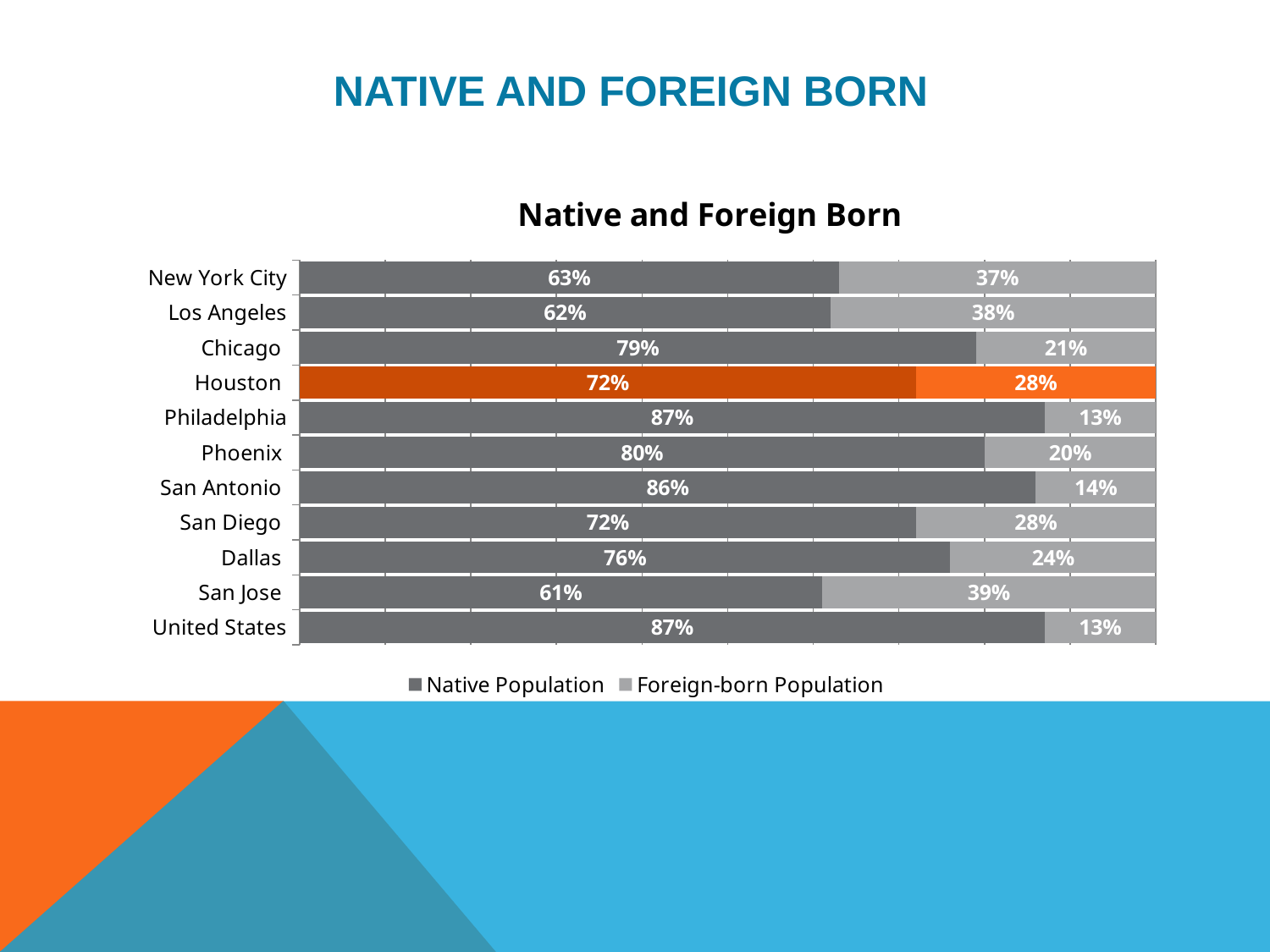
How many categories are shown on the chart? 11 What is the difference between the Native Population values for Philadelphia and Los Angeles? 25% What is the total of the stacked bar for San Diego? 100% Which category has the highest Foreign-born Population value? San Jose What is the Native Population value for Houston? 72% What is the Foreign-born Population value for San Jose? 39% What is the Native Population value for Chicago? 79% Which has a larger Foreign-born Population value, Dallas or Phoenix? Dallas How many series does the legend list? 2 Which category's bar is highlighted in orange? Houston Which category has the lowest Native Population value? San Jose What kind of chart is shown on the slide? Stacked bar chart